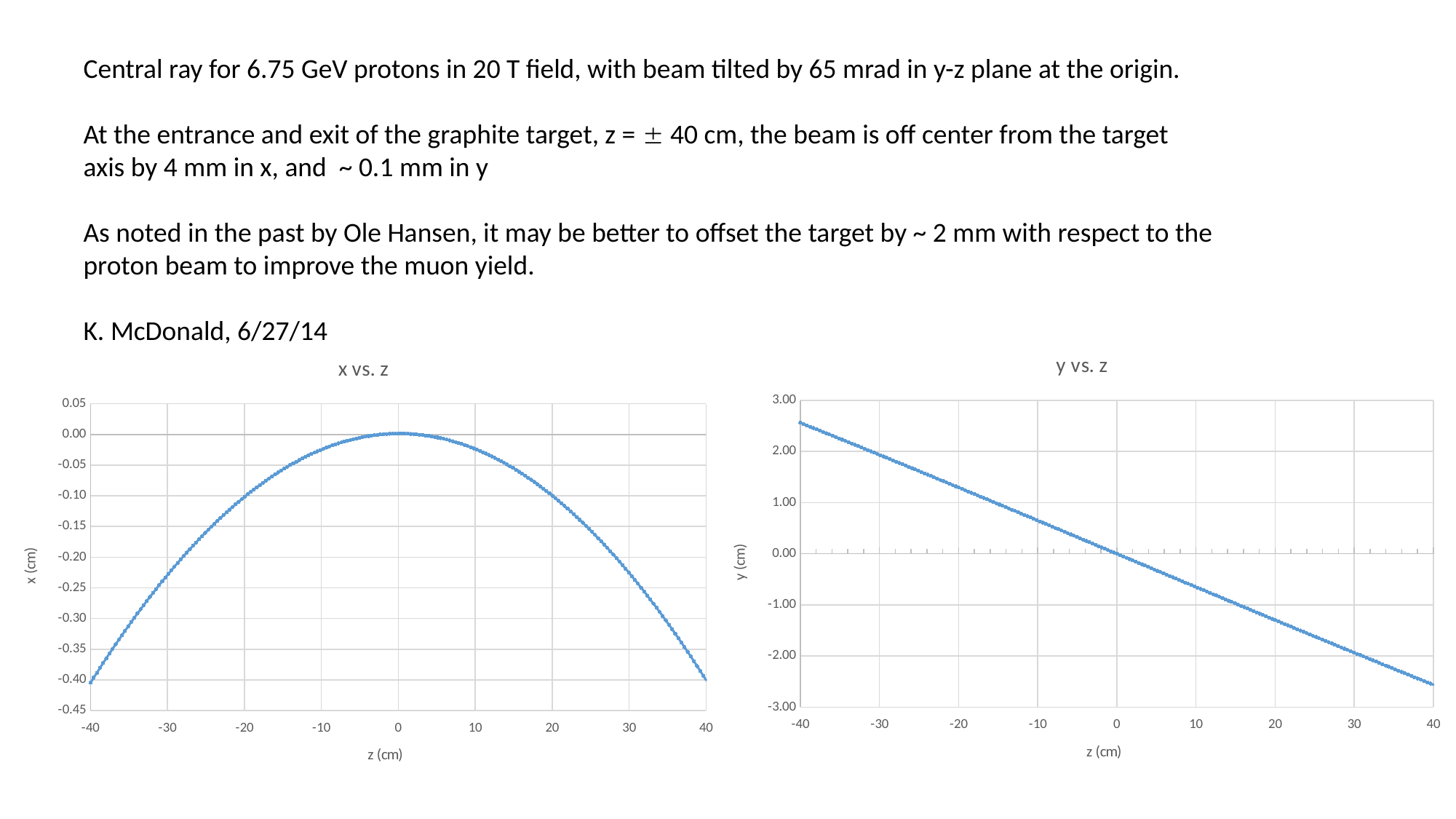
What is the label of the vertical axis of the "y vs. z" chart? y (cm) In the "y vs. z" chart, is the value of y at z = -40 greater or less than 2.00? greater In the "y vs. z" chart, is y larger at z = -30 or at z = 30? z = -30 In the "x vs. z" chart, is the value of x at z = -40 greater or less than -0.35? less What is the title of the chart on the left side of the slide? x vs. z In the "x vs. z" chart, at which z value does x reach its highest point? 0 In the "y vs. z" chart, do the values rise or fall as z increases from -40 to 40? fall In the "x vs. z" chart, is x larger at z = 0 or at z = 40? z = 0 In the "y vs. z" chart, is the value of y at z = 40 greater or less than -2.00? less In the "y vs. z" chart, at which z value is y lowest? 40 What kind of chart is the "x vs. z" chart? line chart